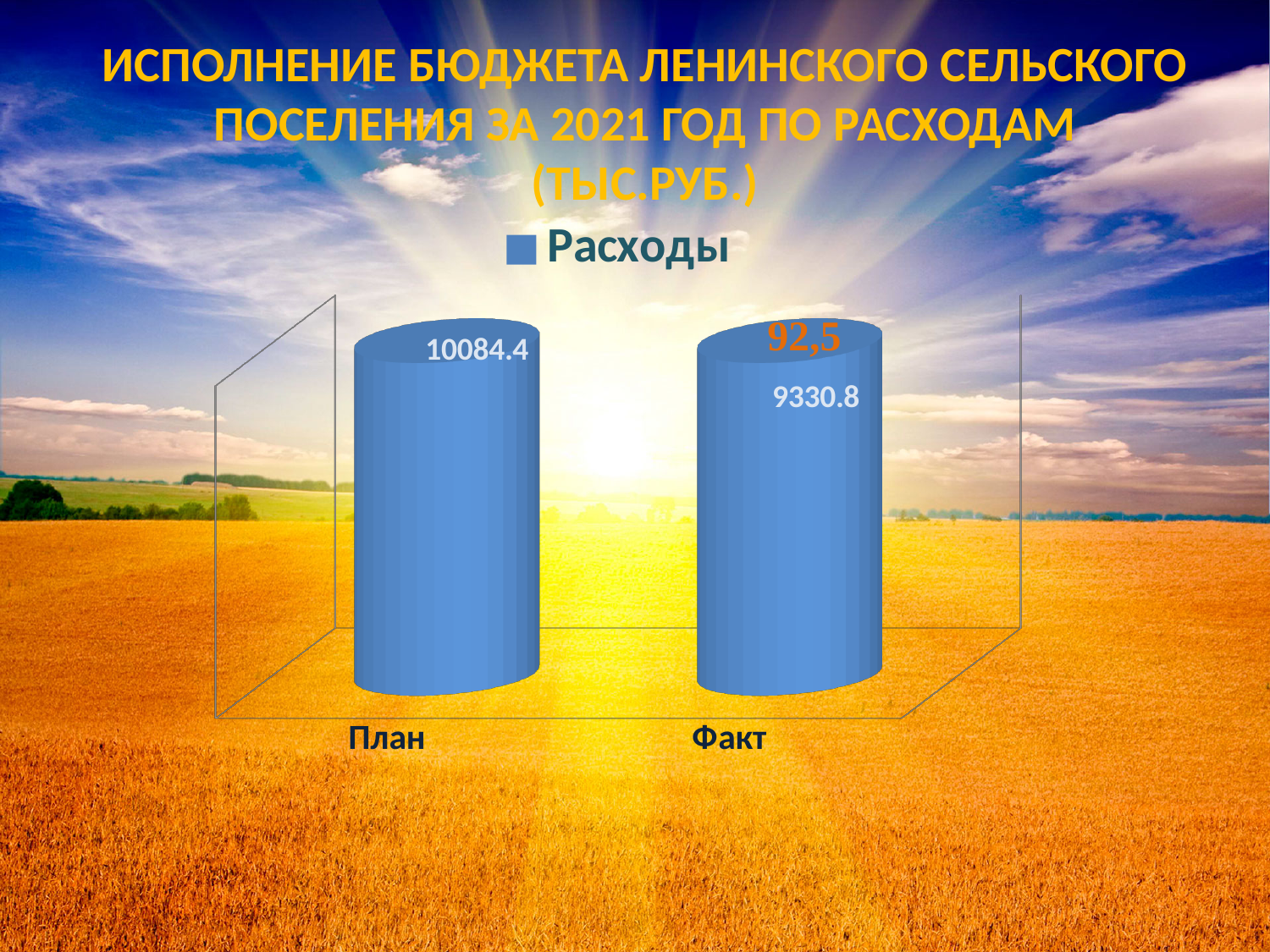
Which is larger, the value for План or the value for Факт? План Which category has the highest value? План What is the difference between the values for План and Факт? 753.6 What kind of chart is shown on the slide? Bar chart How many series does the legend list? 1 How many categories are shown on the chart? 2 Which category has the lowest value? Факт What is the value for Факт? 9330.8 What is the name of the series shown in the legend? Расходы What is the value for План? 10084.4 What number is printed in orange above the Факт bar? 92,5